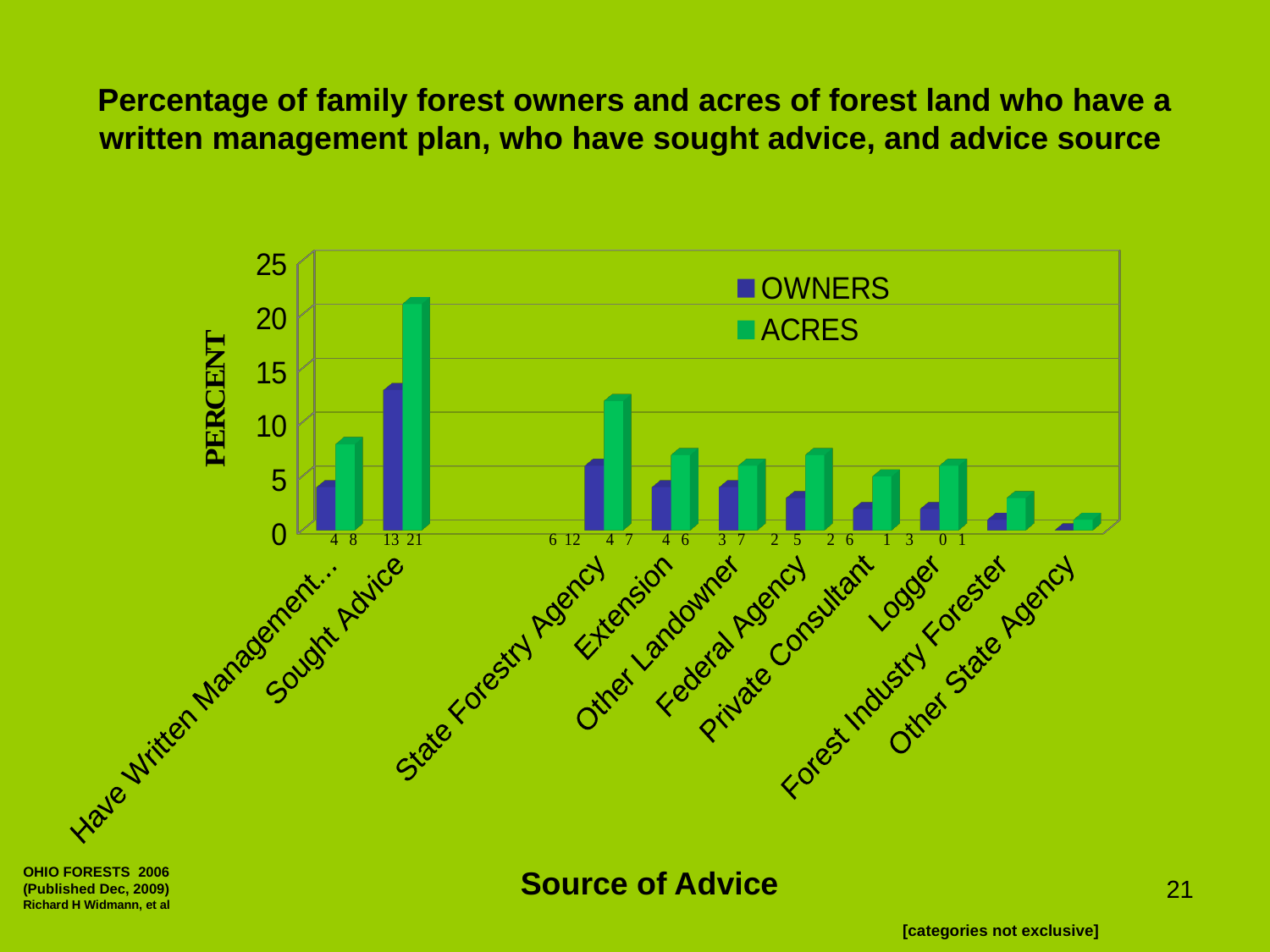
What kind of chart is shown on the slide? bar chart What is the OWNERS value for Logger? 2 Which category has the highest ACRES value? Sought Advice What is the ACRES value for Sought Advice? 21 How many categories are shown on the x axis? 10 Is the ACRES value for Sought Advice greater or less than 20? greater What is the difference between the ACRES and OWNERS values for Sought Advice? 8 Which category has the lowest OWNERS value? Other State Agency What is the title of the vertical axis? PERCENT Which has a larger ACRES value, State Forestry Agency or Extension? State Forestry Agency What is the OWNERS value for State Forestry Agency? 6 How many series does the legend list? 2